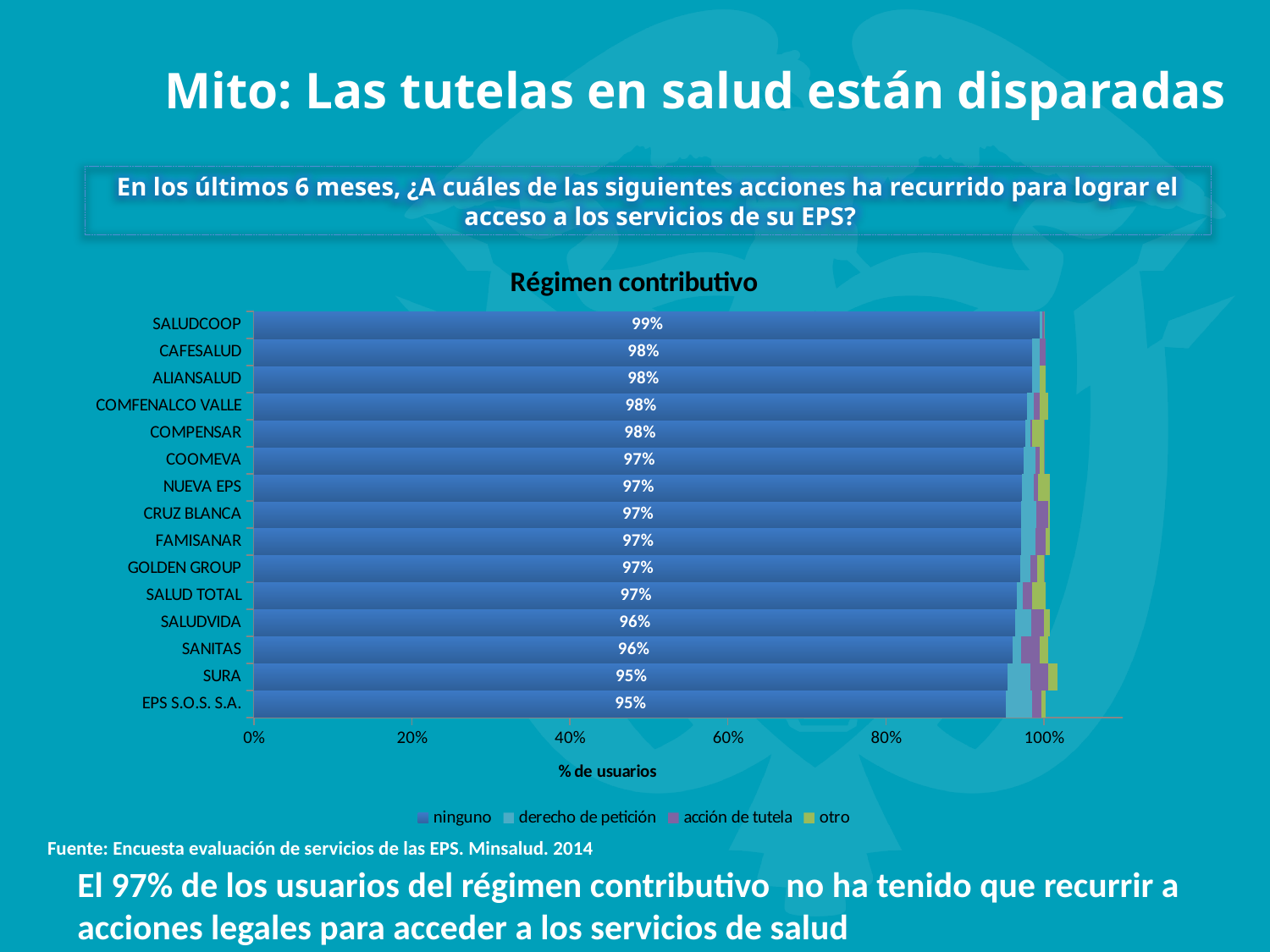
Which has a larger 'ninguno' value, CAFESALUD or SALUDVIDA? CAFESALUD Is the 'ninguno' value for EPS S.O.S. S.A. greater or less than 80%? greater How many series does the legend list? 4 What is the title of the x axis? % de usuarios What is the 'ninguno' value for SANITAS? 96% What is the 'ninguno' value for SURA? 95% How many EPS categories are shown in the chart? 15 What is the 'ninguno' value for SALUDCOOP? 99% What is the 'ninguno' value for COOMEVA? 97% Which EPS has the highest 'ninguno' value? SALUDCOOP What is the difference between the 'ninguno' values for SALUDCOOP and SURA? 4 percentage points What kind of chart is shown on the slide? Stacked bar chart